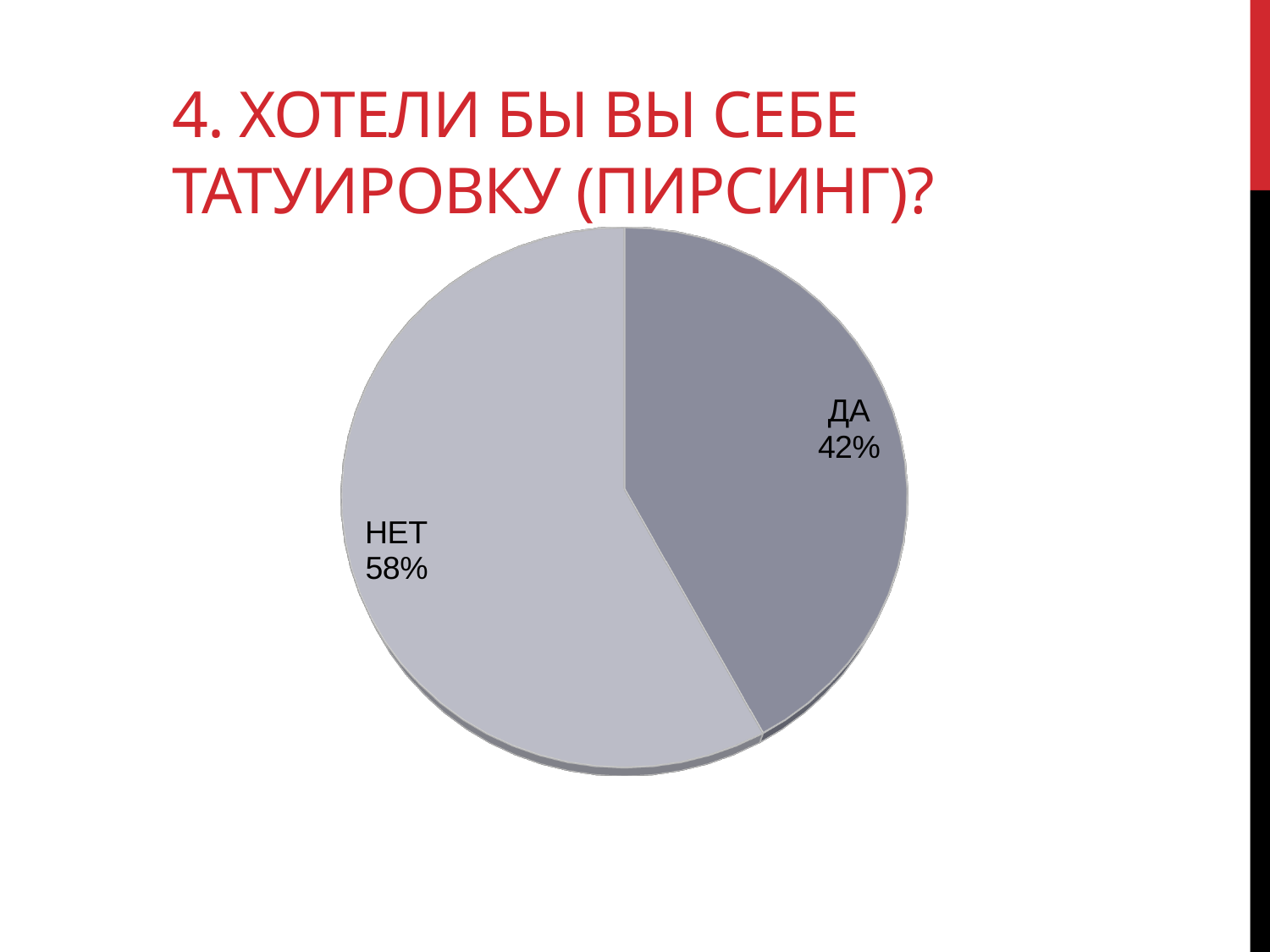
Which slice is the smallest in the pie chart? ДА What is the difference in percentage points between the НЕТ and ДА slices? 16 What share of the pie does the ДА slice represent? 42% What share of the pie does the НЕТ slice represent? 58% Which is larger, the ДА slice or the НЕТ slice? НЕТ Which slice is shown in the darker grey colour? ДА What kind of chart is shown on the slide? pie chart What is the title of the slide above the chart? 4. ХОТЕЛИ БЫ ВЫ СЕБЕ ТАТУИРОВКУ (ПИРСИНГ)? How many slices does the pie chart have? 2 Which slice is the largest in the pie chart? НЕТ